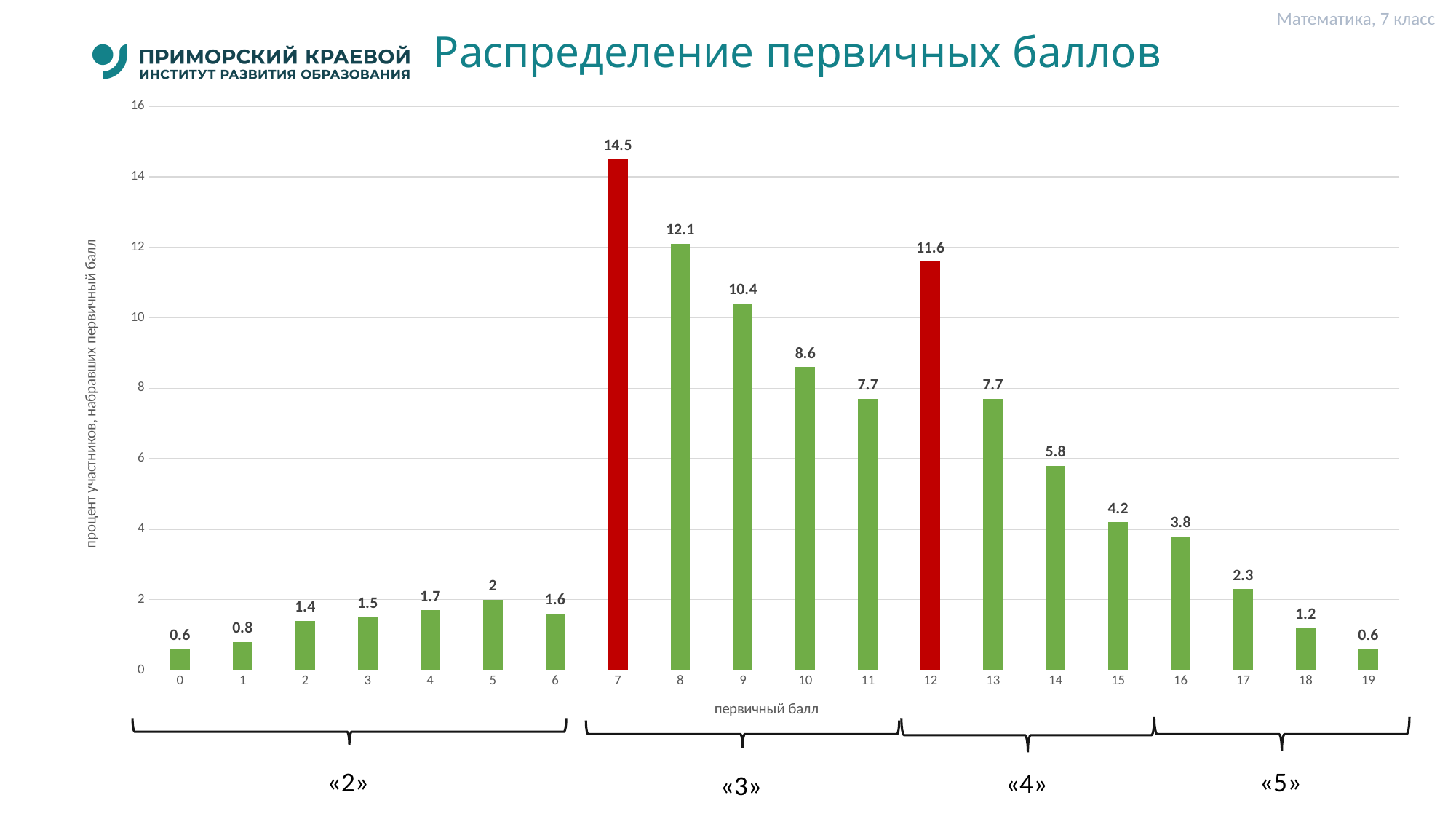
Which two primary scores are shown with red bars? 7 and 12 What is the difference between the values for primary scores 8 and 9? 1.7 What is the value shown for primary score 12? 11.6 What kind of chart is shown on the slide? bar chart What is the value shown for primary score 0? 0.6 Which is larger, the value for primary score 5 or for primary score 6? 5 How many primary score categories are shown on the x axis? 20 Is the value for primary score 10 greater or less than 8? greater What is the title of the chart? Распределение первичных баллов Do the values rise or fall along the x axis from primary score 12 to 19? fall Which primary score has the highest percentage of participants? 7 What percentage of participants scored a primary score of 7? 14.5